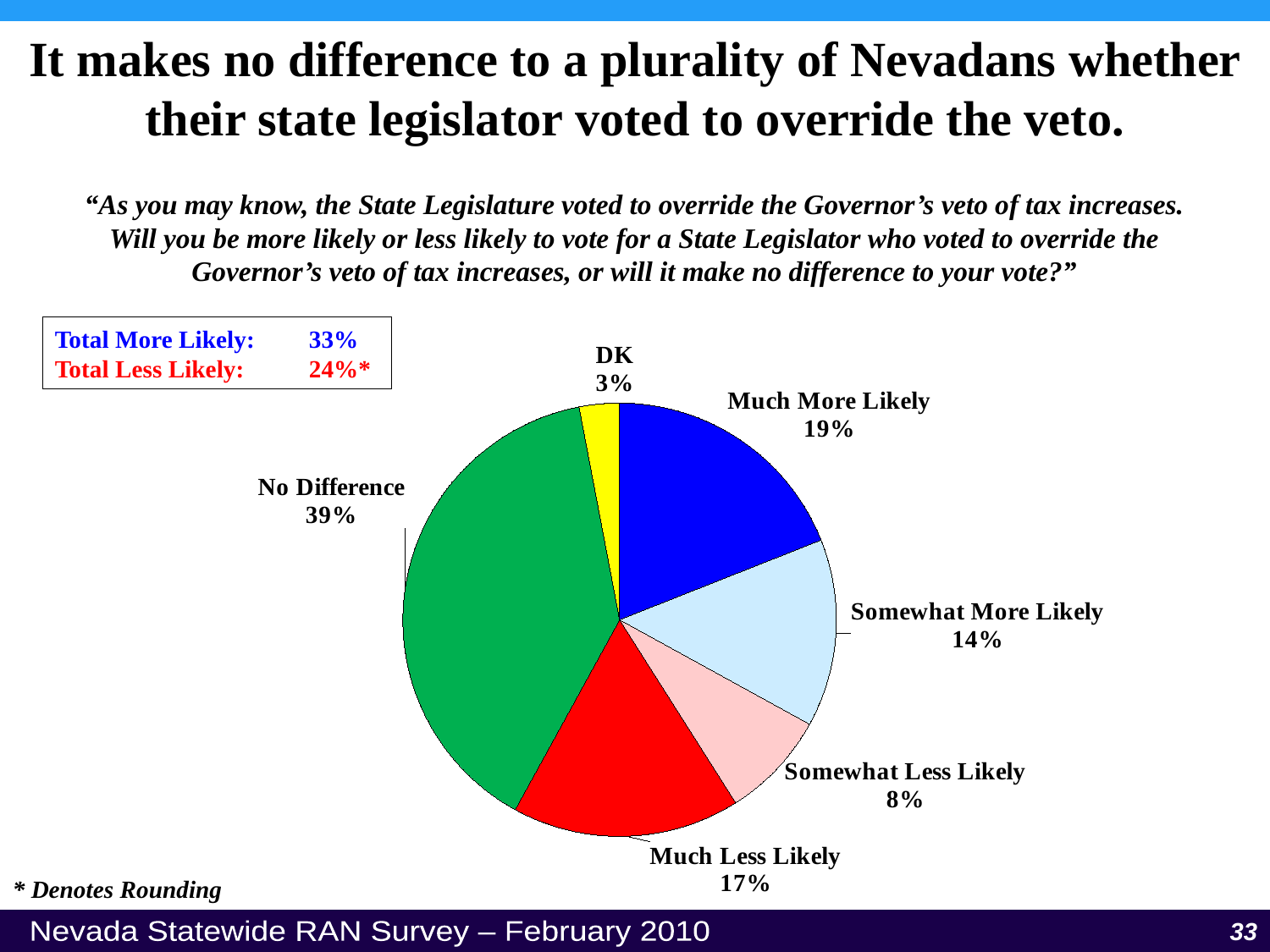
What colour is the No Difference slice? green What percentage of respondents said they would be much more likely to vote for the legislator? 19% How many slices does the pie chart have? 6 Which is larger, Somewhat More Likely or Somewhat Less Likely? Somewhat More Likely What percentage of respondents answered DK? 3% What percentage of respondents said it would make no difference? 39% What is the combined percentage of Much Less Likely and Somewhat Less Likely? 25% What is the difference between the Much More Likely and Much Less Likely percentages? 2% What percentage of respondents said they would be somewhat less likely? 8% What kind of chart is shown on the slide? pie chart Which response has the largest slice of the pie? No Difference Which response has the smallest slice of the pie? DK